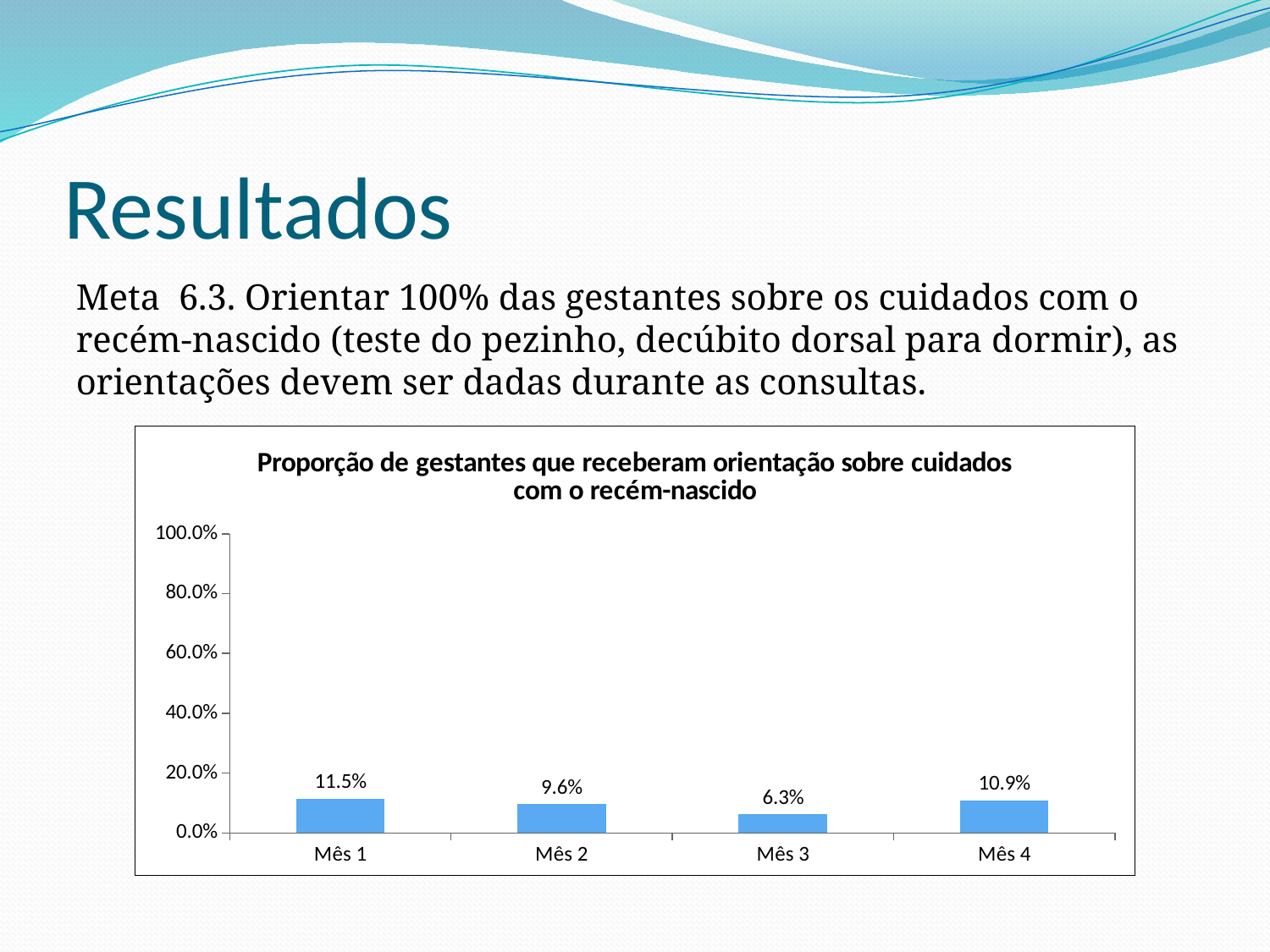
Which month has the highest proportion? Mês 1 What is the difference between the values for Mês 1 and Mês 3? 5.2% What is the value for Mês 3? 6.3% What kind of chart is shown on the slide? bar chart Do the values rise or fall from Mês 1 to Mês 3? fall What is the title of the chart? Proporção de gestantes que receberam orientação sobre cuidados com o recém-nascido What is the value for Mês 1? 11.5% Which month has the lowest proportion? Mês 3 How many months are shown on the x axis? 4 Is the value for Mês 2 greater or less than 20.0%? less Which is larger, the value for Mês 2 or the value for Mês 4? Mês 4 What is the value for Mês 4? 10.9%